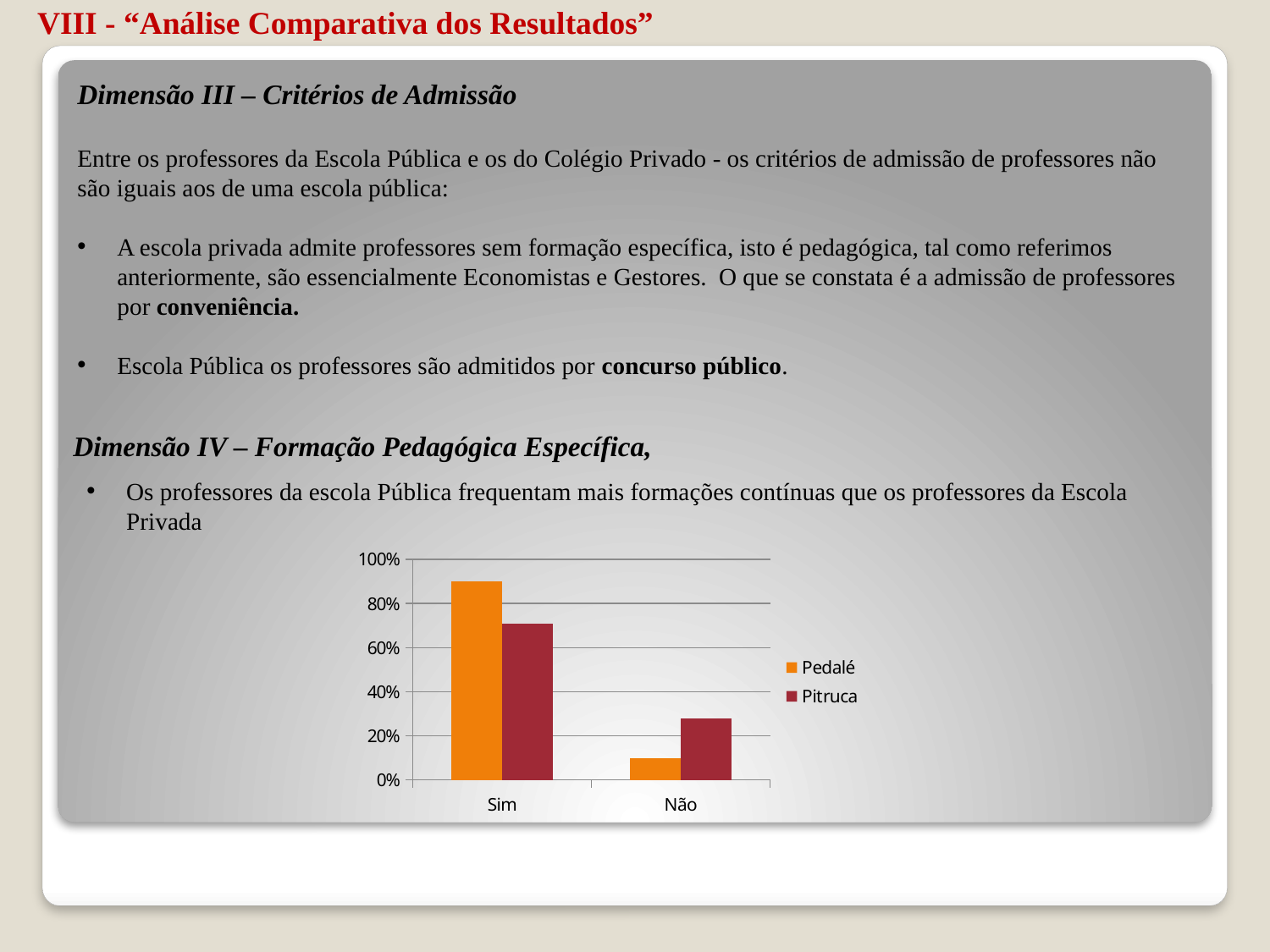
For the Pedalé series, which category has the highest value? Sim Which series is shown in orange in the chart? Pedalé For the category Não, which series has the larger value, Pedalé or Pitruca? Pitruca Which series is shown in dark red in the chart? Pitruca Is the value for Pedalé in the Não category greater or less than 20%? less How many categories are shown on the x axis of the chart? 2 For the Pitruca series, which category has the lowest value? Não How many series does the chart legend list? 2 Is the value for Pitruca in the Sim category greater or less than 60%? greater What kind of chart is shown on the slide? bar chart Is the value for Pedalé in the Sim category greater or less than 80%? greater For the category Sim, which series has the larger value, Pedalé or Pitruca? Pedalé